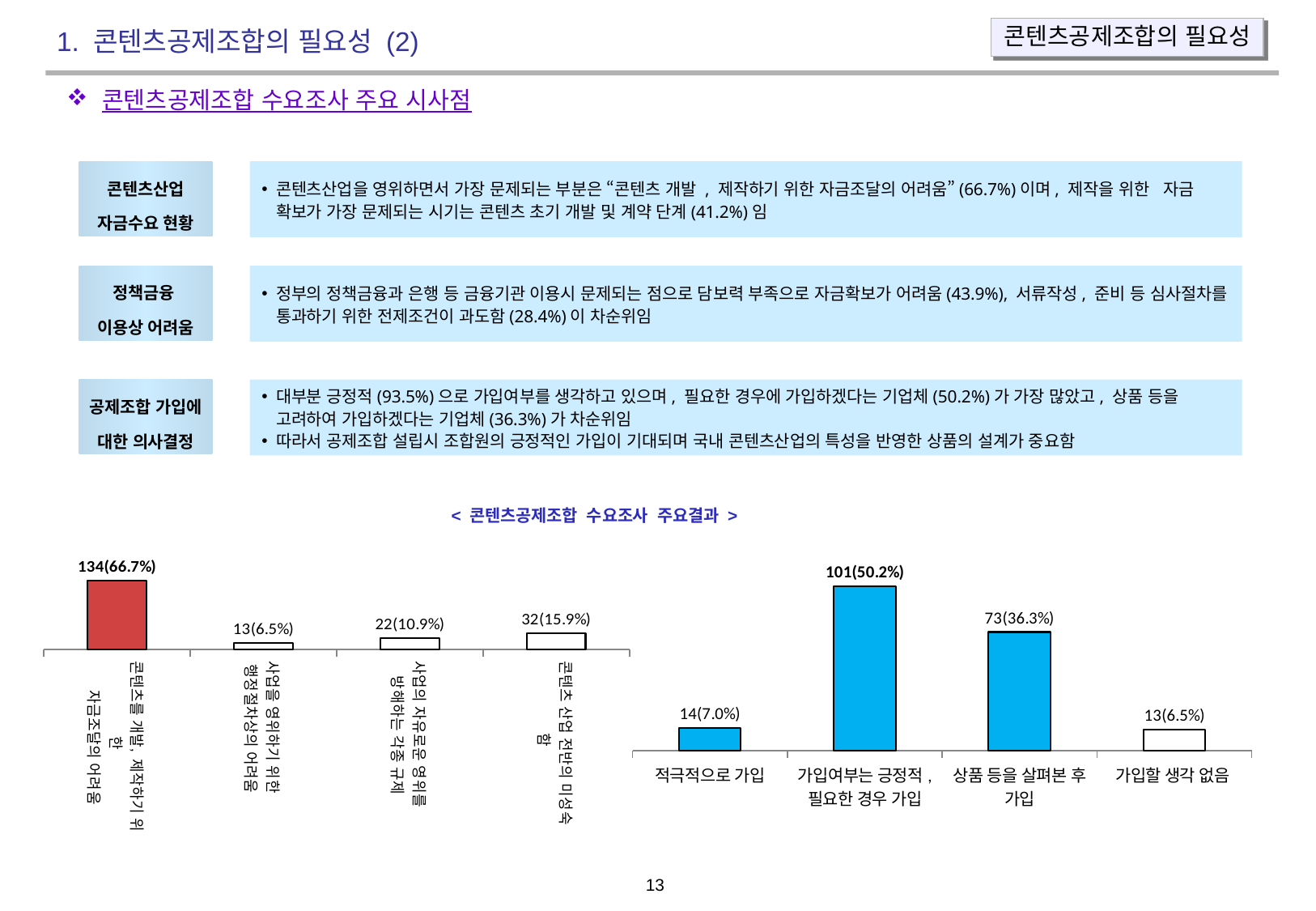
In the left chart, what is the data label on the bar for 콘텐츠를 개발, 제작하기 위한 자금조달의 어려움? 134(66.7%) In the right chart, what is the data label on the bar for 적극적으로 가입? 14(7.0%) In the left chart, what is the difference in count between 콘텐츠 산업 전반의 미성숙함 and 사업의 자유로운 영위를 방해하는 각종 규제? 10 In the right chart, which category has the highest value? 가입여부는 긍정적, 필요한 경우 가입 What type of chart is the right chart? Bar chart In the left chart, which bar is coloured red? 콘텐츠를 개발, 제작하기 위한 자금조달의 어려움 In the right chart, what is the data label on the bar for 가입여부는 긍정적, 필요한 경우 가입? 101(50.2%) In the left chart, which category has the lowest value? 사업을 영위하기 위한 행정절차상의 어려움 In the left chart, what is the data label on the bar for 콘텐츠 산업 전반의 미성숙함? 32(15.9%) In the right chart, which is larger: 상품 등을 살펴본 후 가입 or 가입할 생각 없음? 상품 등을 살펴본 후 가입 In the left chart, how many categories are plotted? 4 In the right chart, what is the difference in count between 가입여부는 긍정적, 필요한 경우 가입 and 상품 등을 살펴본 후 가입? 28